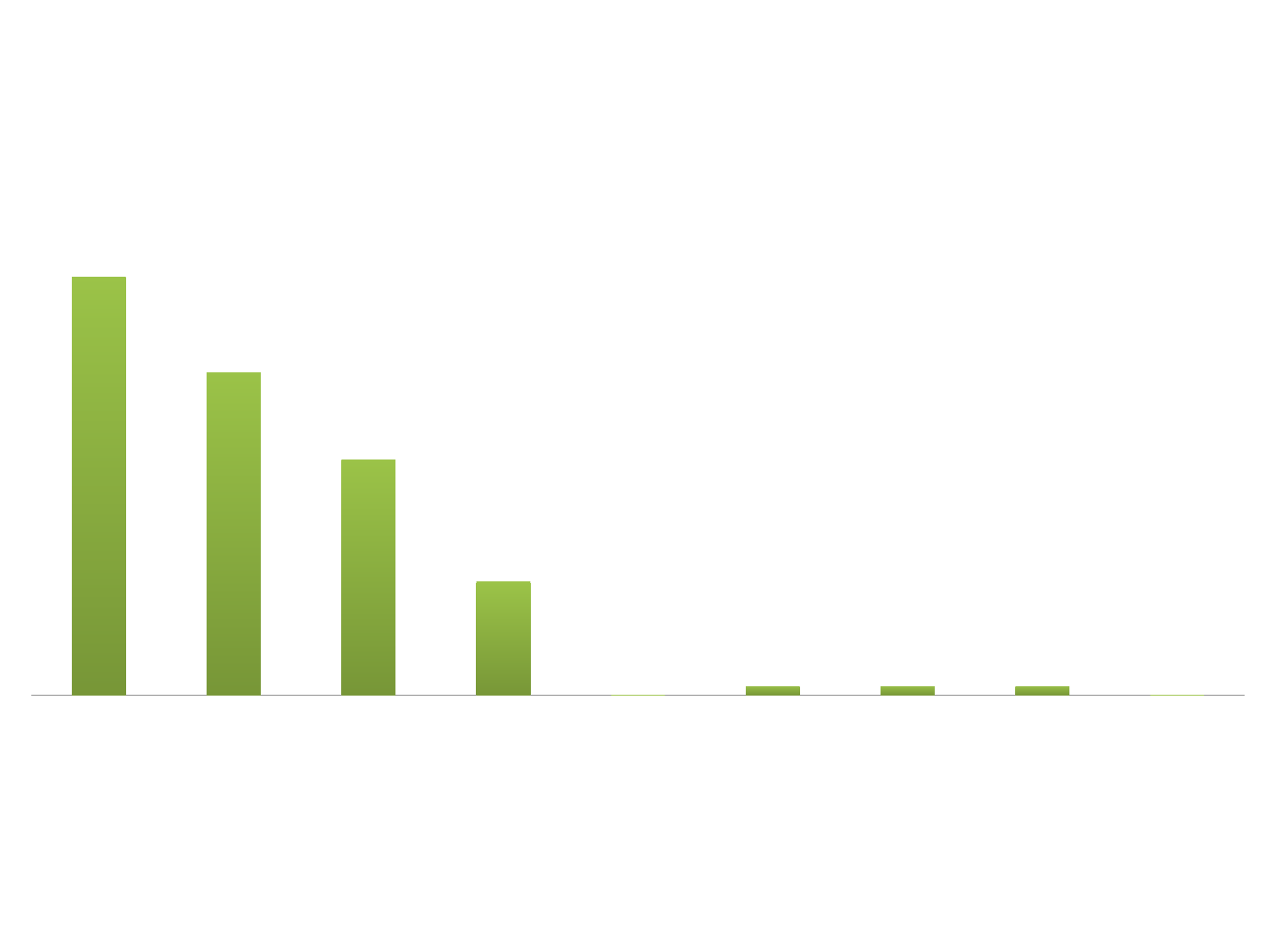
Which bar is the tallest in the chart? The leftmost (first) bar Which is taller, the fourth bar from the left or the third bar from the left? The third bar What kind of chart is shown on the slide? Bar chart What colour are the bars in the chart? Green Which is taller, the first bar from the left or the second bar from the left? The first bar Do the bar values generally rise or fall from left to right across the chart? Fall Does the chart display a legend? No